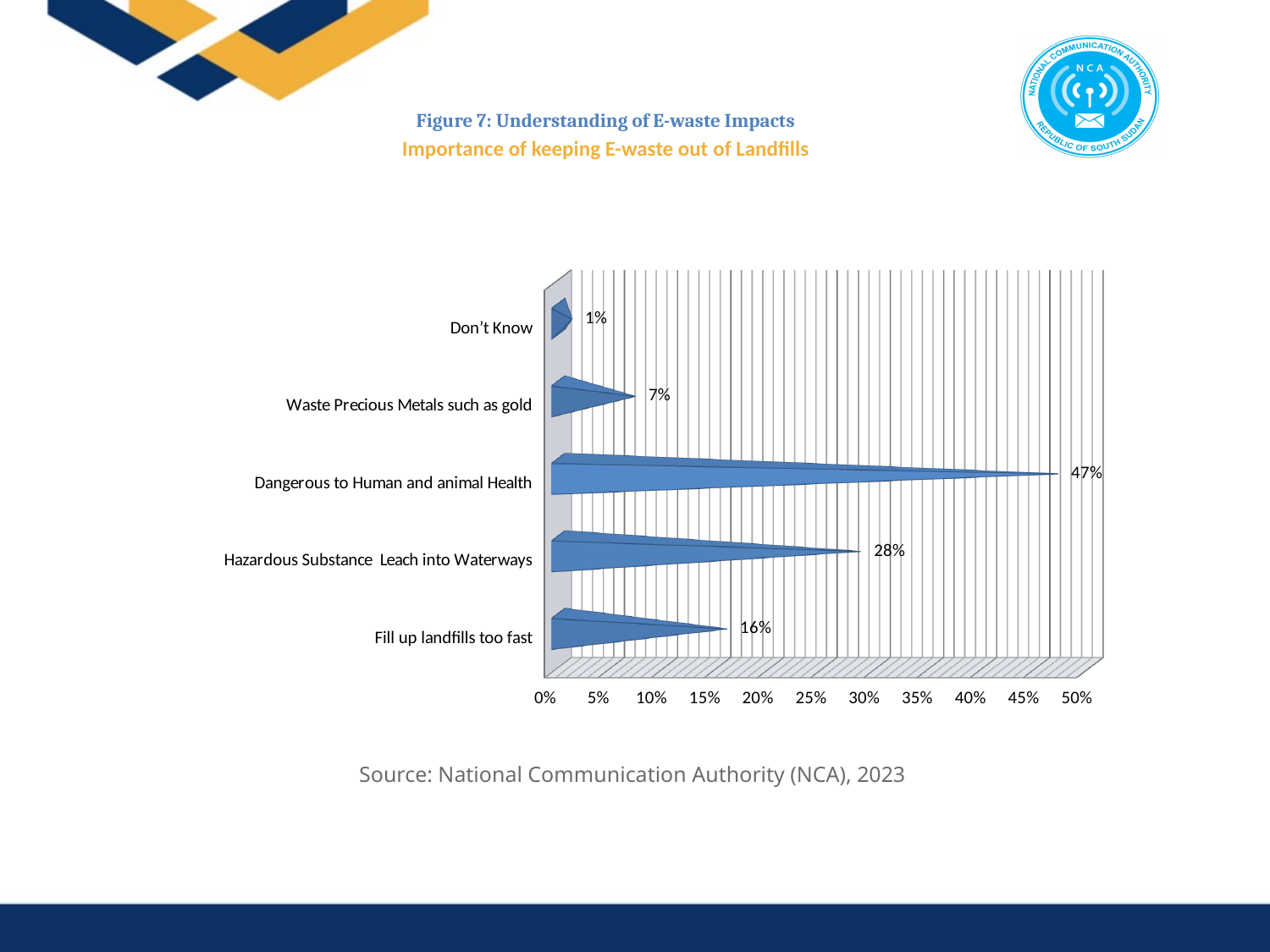
What is the value for Fill up landfills too fast? 16% What is the difference between the values for Dangerous to Human and animal Health and Hazardous Substance Leach into Waterways? 19% What is the value for Waste Precious Metals such as gold? 7% What is the value for Dangerous to Human and animal Health? 47% Is the value for Hazardous Substance Leach into Waterways greater or less than 25%? greater What is the value for Hazardous Substance Leach into Waterways? 28% Which is larger, the value for Fill up landfills too fast or the value for Waste Precious Metals such as gold? Fill up landfills too fast What is the value for Don't Know? 1% Which category has the highest value? Dangerous to Human and animal Health Which category has the lowest value? Don't Know How many categories are shown in the chart? 5 What kind of chart is shown on the slide? Bar chart